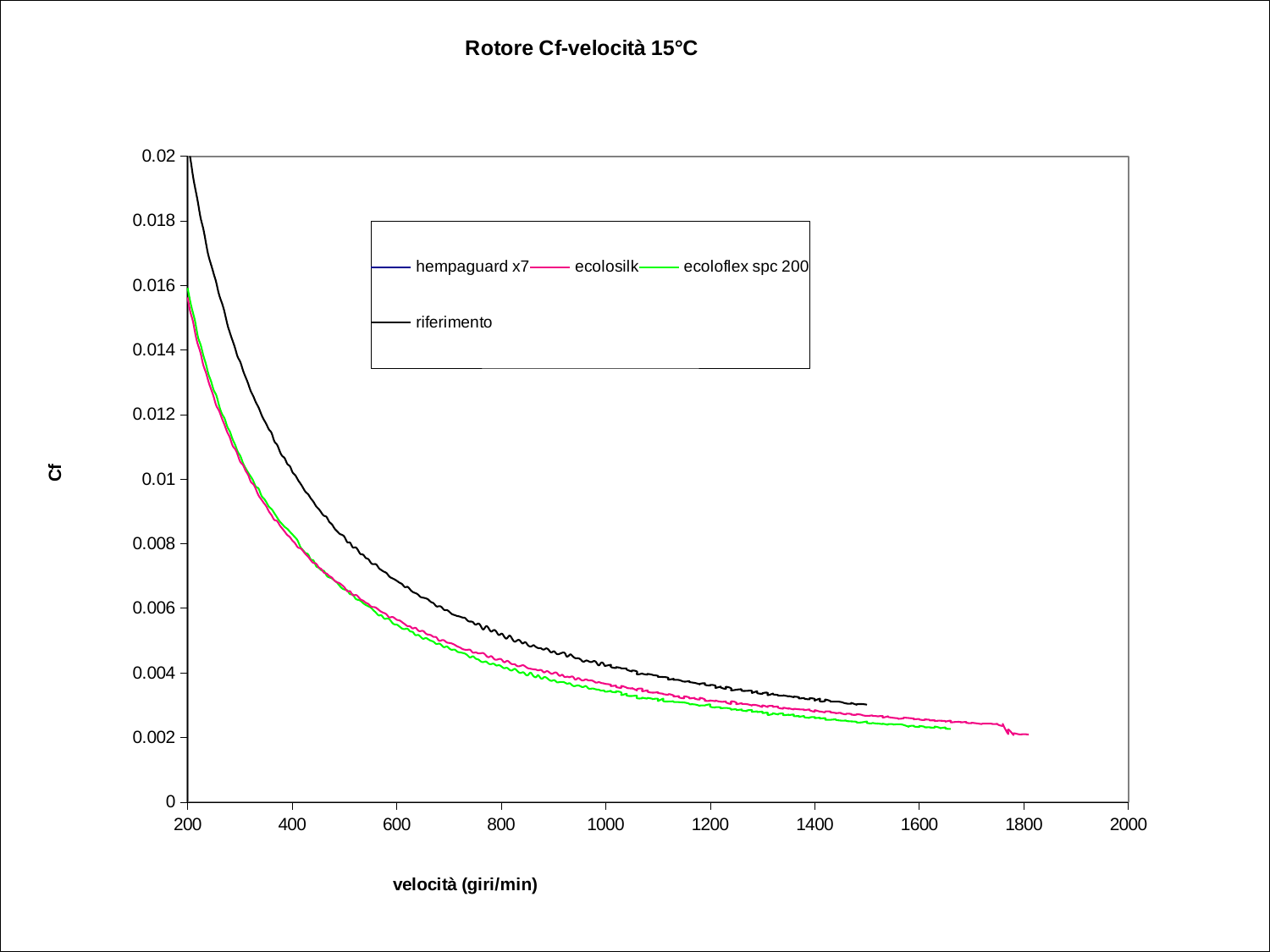
Is the value of the riferimento series at 1400 giri/min greater or less than 0.004? less Is the value of the ecoloflex spc 200 series at 1600 giri/min greater or less than 0.004? less At 1000 giri/min, which series has the larger Cf value, riferimento or ecoloflex spc 200? riferimento How many series does the legend list? 4 Which series has the highest Cf value at 200 giri/min? riferimento Which series extends to the highest velocità on the x axis? ecolosilk Is the value of the riferimento series at 600 giri/min greater or less than 0.006? greater What is the label of the x axis? velocità (giri/min) What is the title of the chart? Rotore Cf-velocità 15°C Does Cf rise or fall as velocità increases along the x axis? fall What kind of chart is shown on the slide? line chart